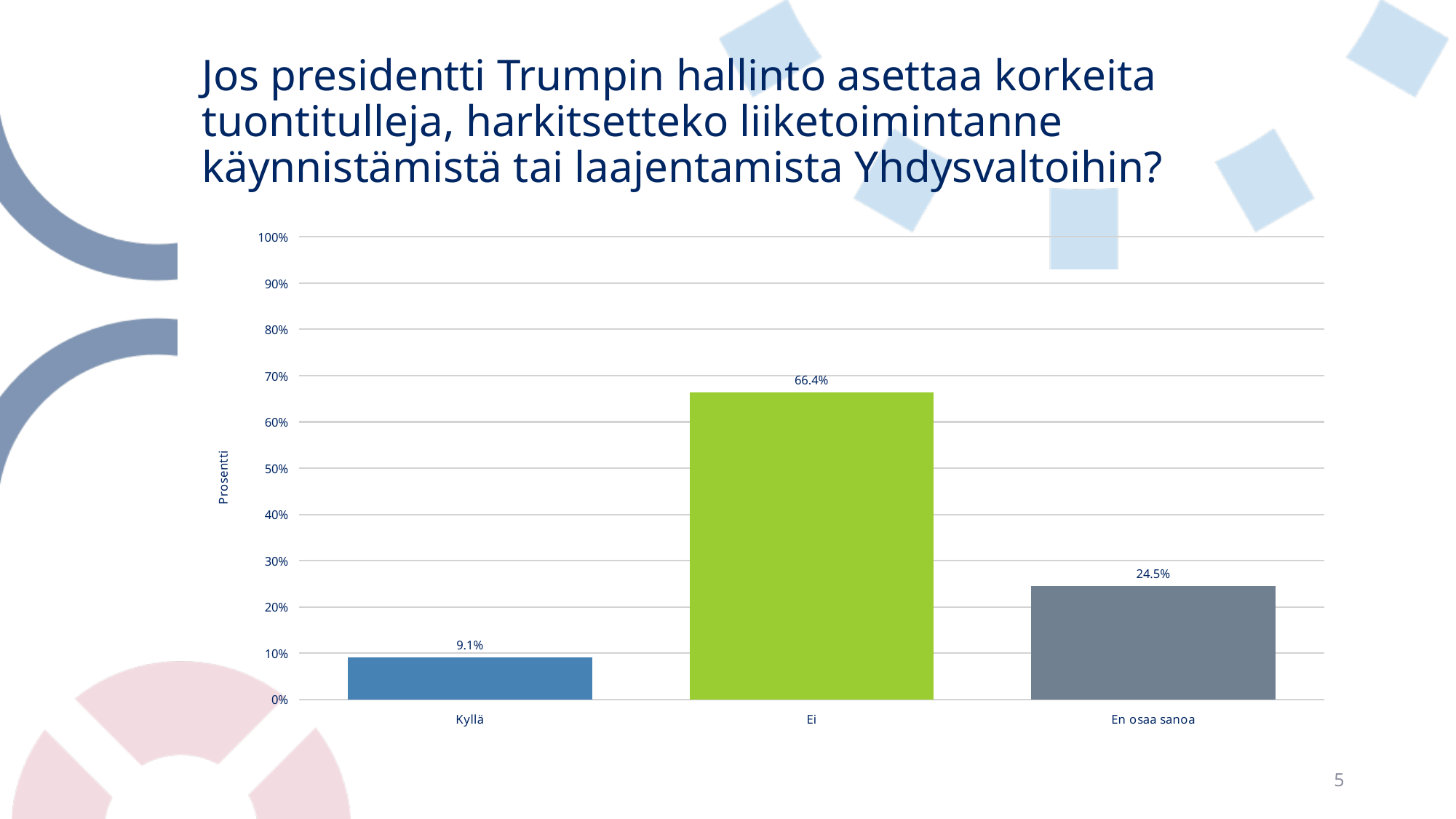
What is the difference between the values for Ei and En osaa sanoa? 41.9% What kind of chart is shown on the slide? bar chart Which category has the lowest value? Kyllä What is the difference between the values for En osaa sanoa and Kyllä? 15.4% Which is larger, the value for Kyllä or the value for En osaa sanoa? En osaa sanoa What is the value for Kyllä? 9.1% What is the value for Ei? 66.4% What is the label of the vertical axis? Prosentti Is the value for Ei greater or less than 60%? greater Which category has the highest value? Ei How many categories are shown on the x axis? 3 What is the value for En osaa sanoa? 24.5%